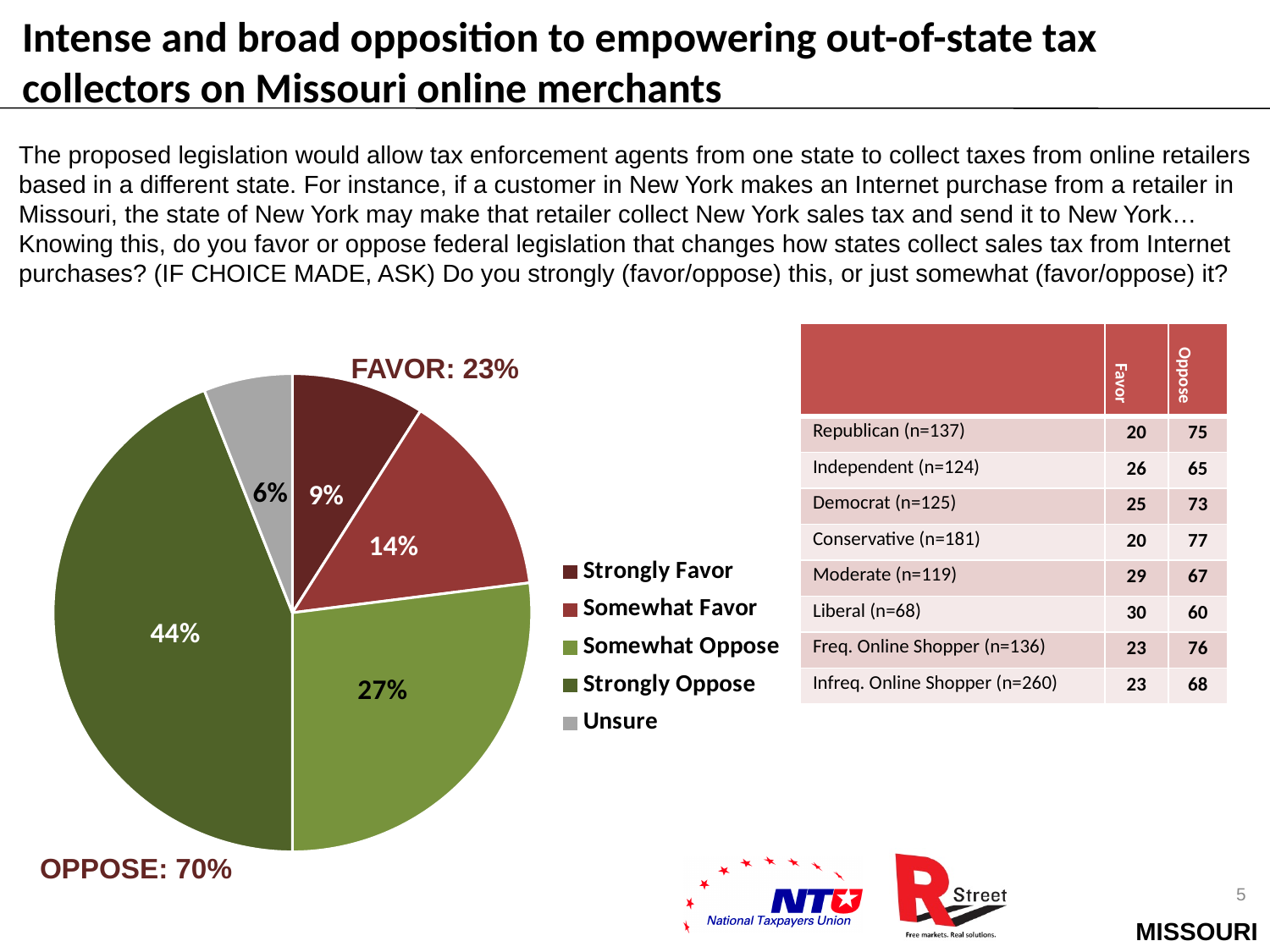
Which slice of the pie chart is the largest? Strongly Oppose What percentage of the pie is Strongly Favor? 9% How many entries does the pie chart legend list? 5 What kind of chart is shown on the slide? Pie chart How many slices does the pie chart have? 5 What percentage of the pie is Strongly Oppose? 44% What percentage of the pie is Unsure? 6% What is the difference in percentage points between Strongly Oppose and Somewhat Oppose? 17 What total percentage is labelled for OPPOSE on the pie chart? 70% Which slice of the pie chart is the smallest? Unsure What percentage of the pie is Somewhat Favor? 14% Which is larger in the pie chart, Somewhat Favor or Somewhat Oppose? Somewhat Oppose